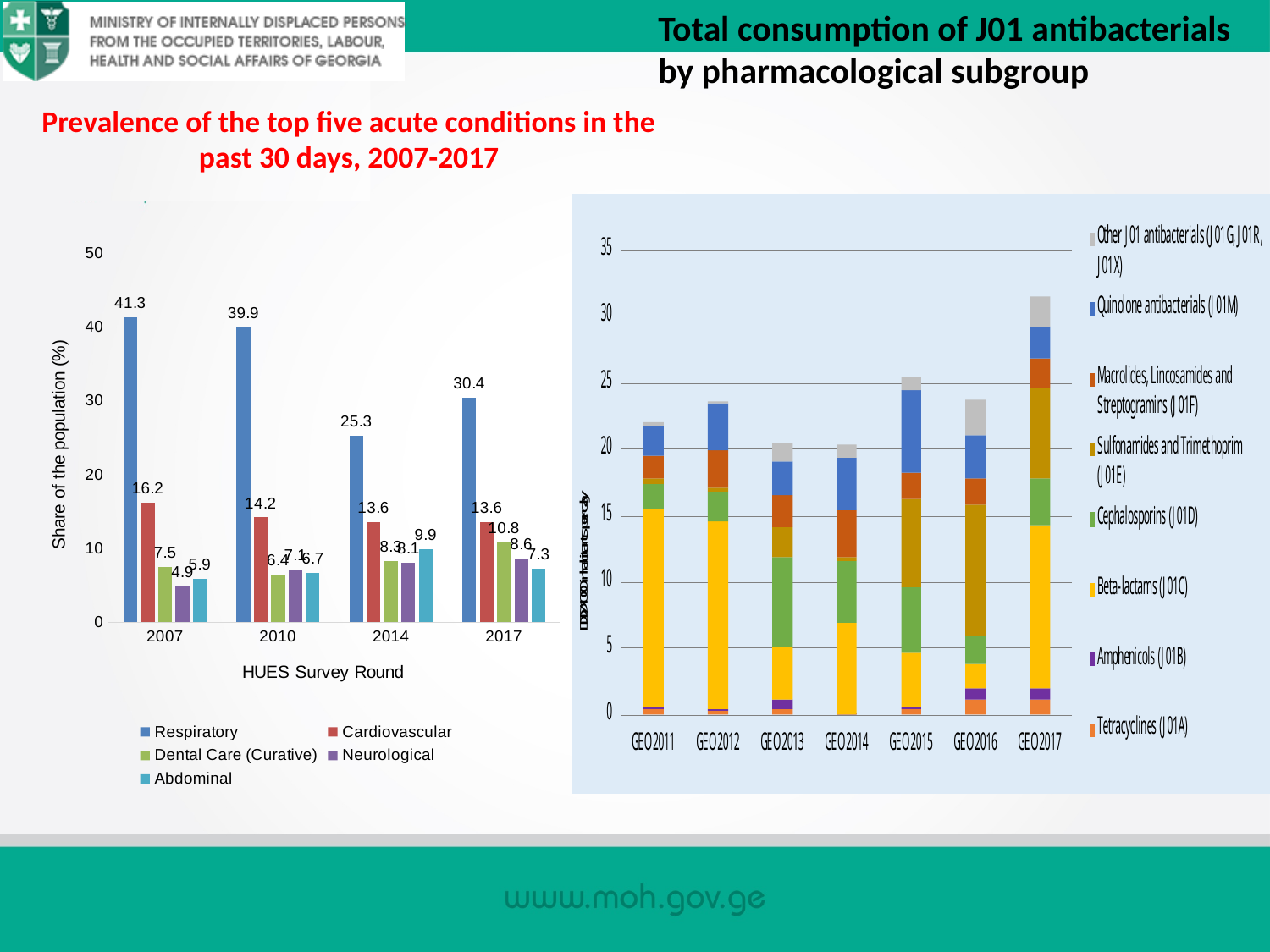
How many years (categories) are shown on the x axis of the 'Total consumption of J01 antibacterials' chart? 7 In the 'Total consumption of J01 antibacterials' chart, is the total for GEO2017 greater or less than 30? greater In the 'Prevalence of the top five acute conditions' chart, what is the value for Abdominal in 2014? 9.9 In the 'Prevalence of the top five acute conditions' chart, what is the value for Cardiovascular in 2010? 14.2 In the 'Prevalence of the top five acute conditions' chart, which is larger in 2017: Dental Care (Curative) or Abdominal? Dental Care (Curative) In the 'Prevalence of the top five acute conditions' chart, which survey round has the lowest Respiratory value? 2014 What kind of chart is the 'Total consumption of J01 antibacterials by pharmacological subgroup' chart? Stacked bar chart In the 'Prevalence of the top five acute conditions' chart, what is the difference between the Respiratory values for 2007 and 2017? 10.9 How many series does the legend of the 'Prevalence of the top five acute conditions' chart list? 5 In the 'Prevalence of the top five acute conditions' chart, which survey round has the highest Respiratory value? 2007 In the 'Prevalence of the top five acute conditions' chart, what is the value for Respiratory in 2007? 41.3 In the 'Total consumption of J01 antibacterials' chart, which year has the tallest stacked bar? GEO2017